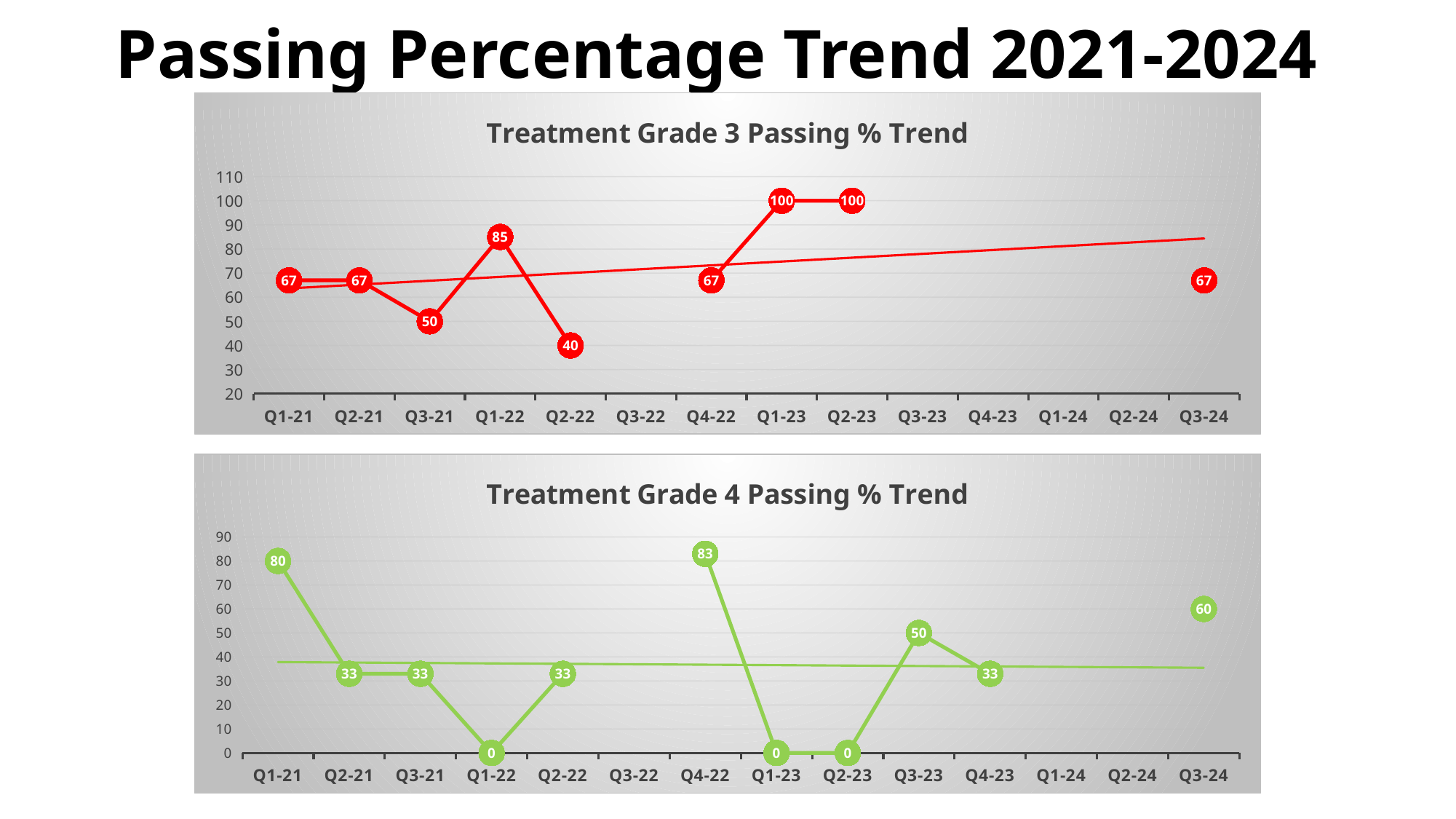
How many quarter labels are shown on the x axis of the Treatment Grade 4 Passing % Trend chart? 14 In the Treatment Grade 4 Passing % Trend chart, what is the value for Q4-22? 83 In the Treatment Grade 4 Passing % Trend chart, what is the value for Q3-24? 60 What kind of chart is the Treatment Grade 3 Passing % Trend chart? Line chart In the Treatment Grade 3 Passing % Trend chart, what is the value for Q2-22? 40 In the Treatment Grade 4 Passing % Trend chart, what is the difference between the Q1-21 value and the Q3-23 value? 30 In the Treatment Grade 3 Passing % Trend chart, what is the value for Q1-22? 85 In the Treatment Grade 3 Passing % Trend chart, which is larger, the value for Q1-22 or the value for Q4-22? Q1-22 In the Treatment Grade 3 Passing % Trend chart, which quarter has the lowest plotted value? Q2-22 In the Treatment Grade 4 Passing % Trend chart, which quarter has the highest plotted value? Q4-22 In the Treatment Grade 3 Passing % Trend chart, what is the difference between the Q1-23 value and the Q3-21 value? 50 What is the title of the bottom chart on the slide? Treatment Grade 4 Passing % Trend